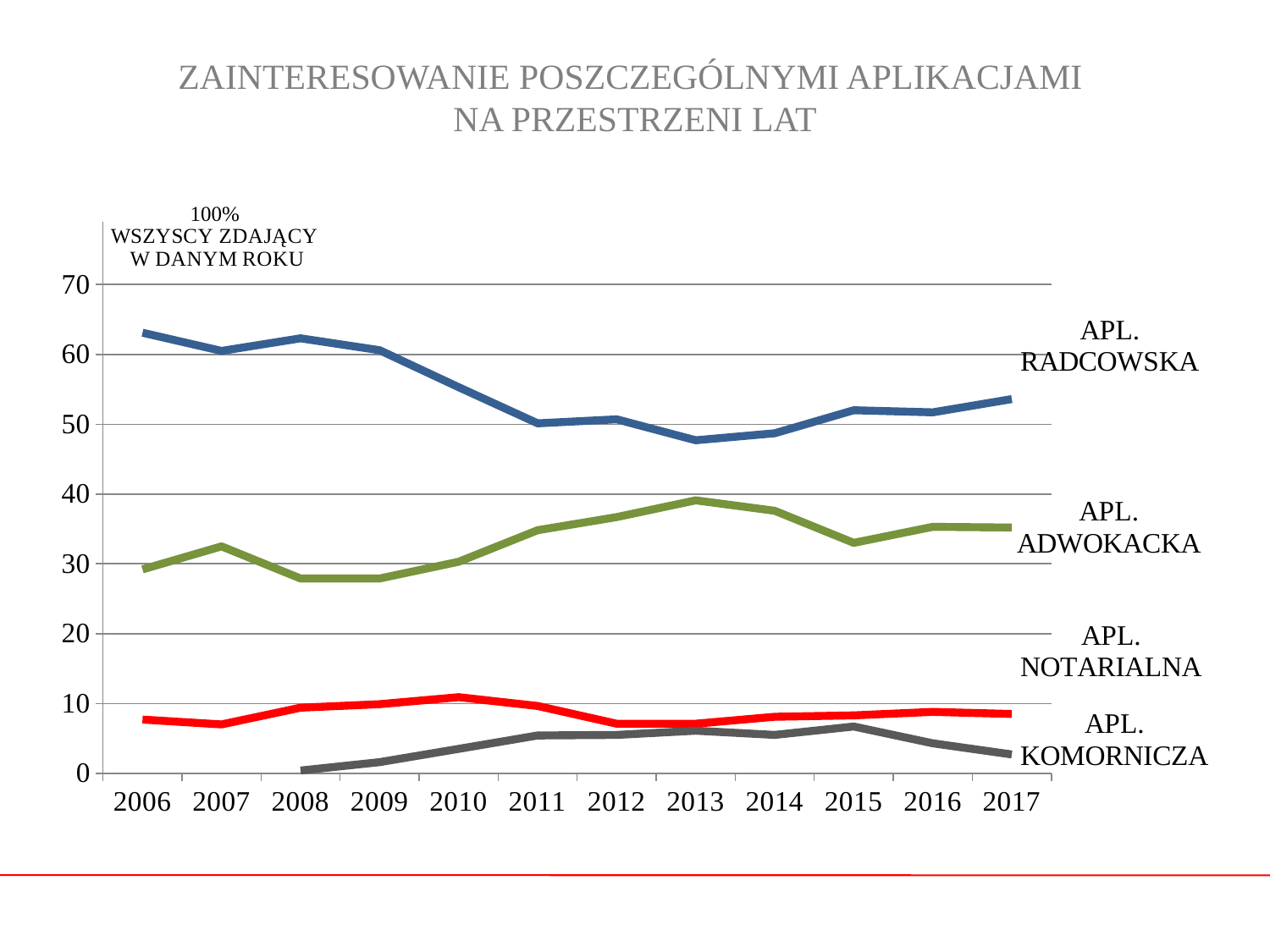
Is the value for APL. RADCOWSKA in 2006 greater or less than 60? greater Which series has the highest value in 2006? APL. RADCOWSKA How many series are labelled on the chart? 4 Which series only begins in 2008 rather than 2006? APL. KOMORNICZA Is the value for APL. KOMORNICZA in 2017 greater or less than 10? less What kind of chart is shown on the slide? line chart Which is larger in 2017, APL. RADCOWSKA or APL. ADWOKACKA? APL. RADCOWSKA Does the APL. RADCOWSKA line rise or fall between 2006 and 2013? fall Is the value for APL. ADWOKACKA in 2008 greater or less than 30? less How many years are shown on the x axis? 12 Which series has the lowest value in 2017? APL. KOMORNICZA